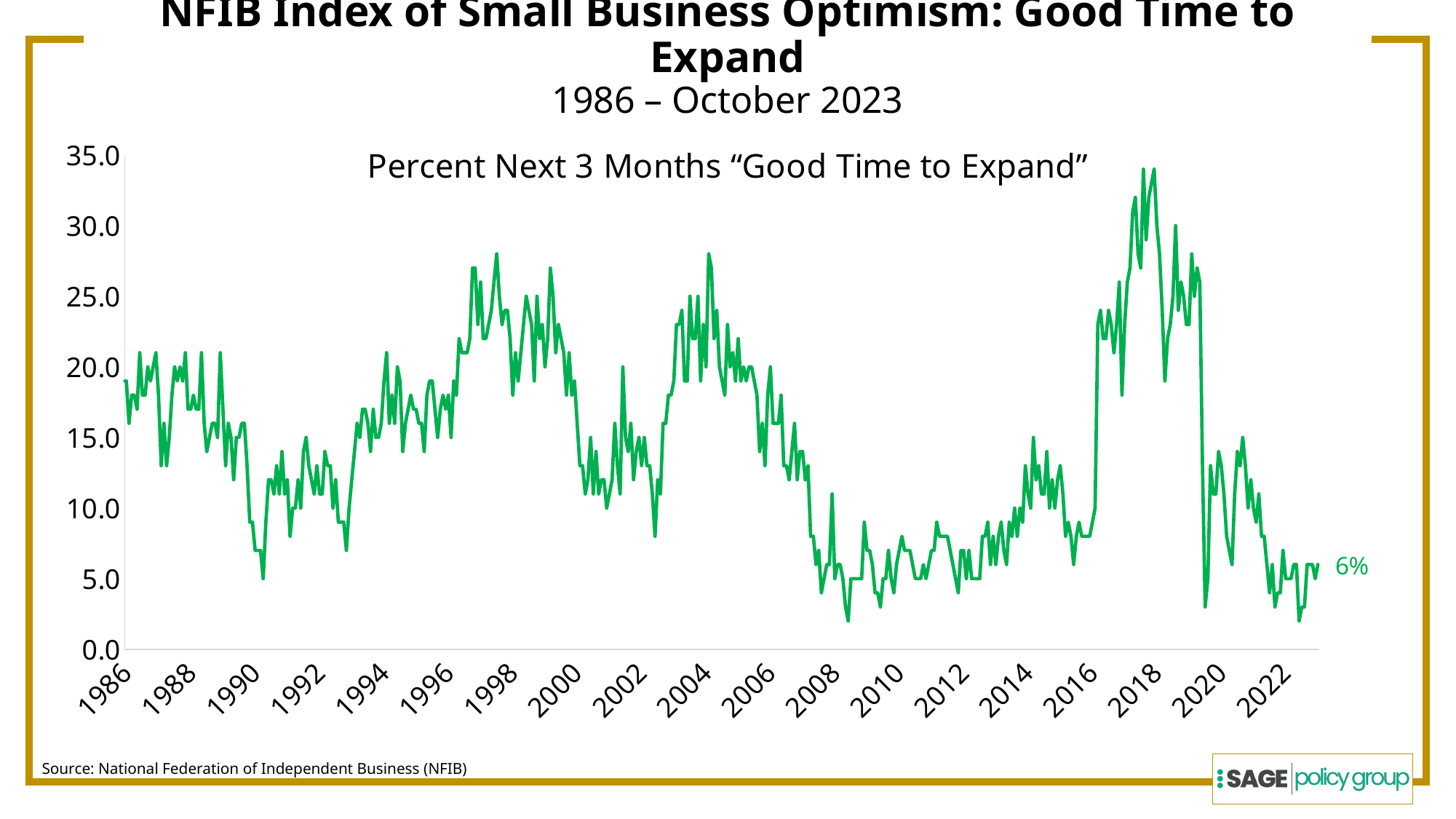
What is the value shown by the data label at the end of the line, for October 2023? 6% What kind of chart is shown on the slide? line chart Which is larger, the peak around 2004 or the peak around 2018? the peak around 2018 Does the line rise or fall between 2018 and 2020? fall Is the peak value reached around 2018 greater or less than 30? greater What is the highest tick value shown on the y axis? 35.0 Around which year does the line reach its highest value? 2018 Is the peak value reached around 2004 greater or less than 25? greater What is the label printed inside the plot area describing the series? Percent Next 3 Months "Good Time to Expand" Does the line rise or fall between 2016 and 2018? rise Is the value at the start of the series in 1986 greater or less than 15? greater